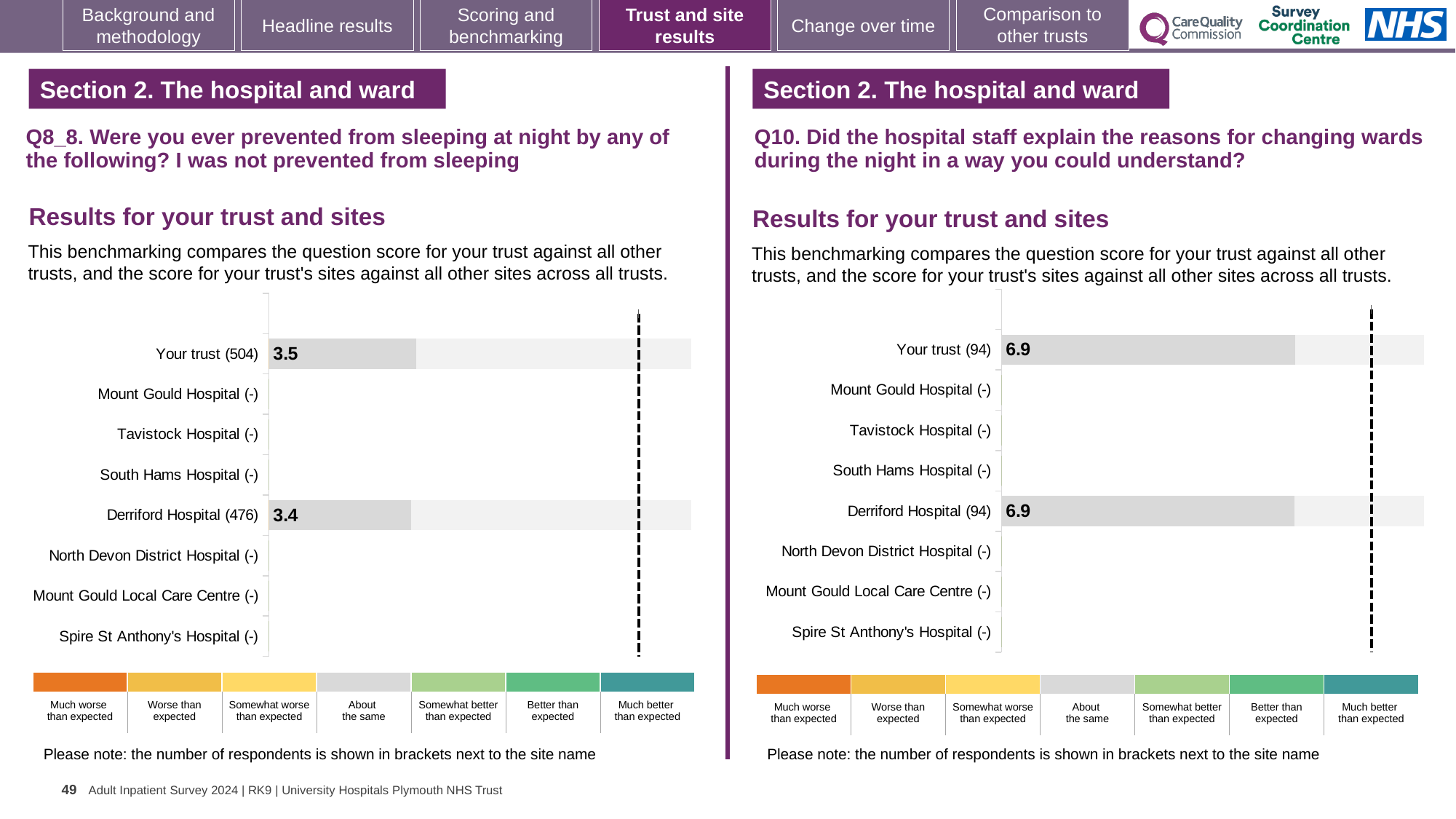
On the left chart (Q8_8), how many respondents are shown in brackets for Derriford Hospital? 476 On the right chart (Q10), what is the score for Your trust? 6.9 On the left chart (Q8_8), what is the score for Your trust? 3.5 On the right chart (Q10), how many respondents are shown in brackets for Your trust? 94 On the left chart (Q8_8), what is the difference between the score for Your trust and the score for Derriford Hospital? 0.1 On the left chart (Q8_8), how many categories have a plotted bar with a value shown? 2 How many site or trust categories are listed on the left chart (Q8_8)? 8 What kind of chart is used on the right (Q10)? Bar chart On the right chart (Q10), what is the score for Derriford Hospital? 6.9 On the left chart (Q8_8), what is the score for Derriford Hospital? 3.4 On the left chart (Q8_8), which has the higher score, Your trust or Derriford Hospital? Your trust On the right chart (Q10), what is the difference between the score for Your trust and the score for Derriford Hospital? 0